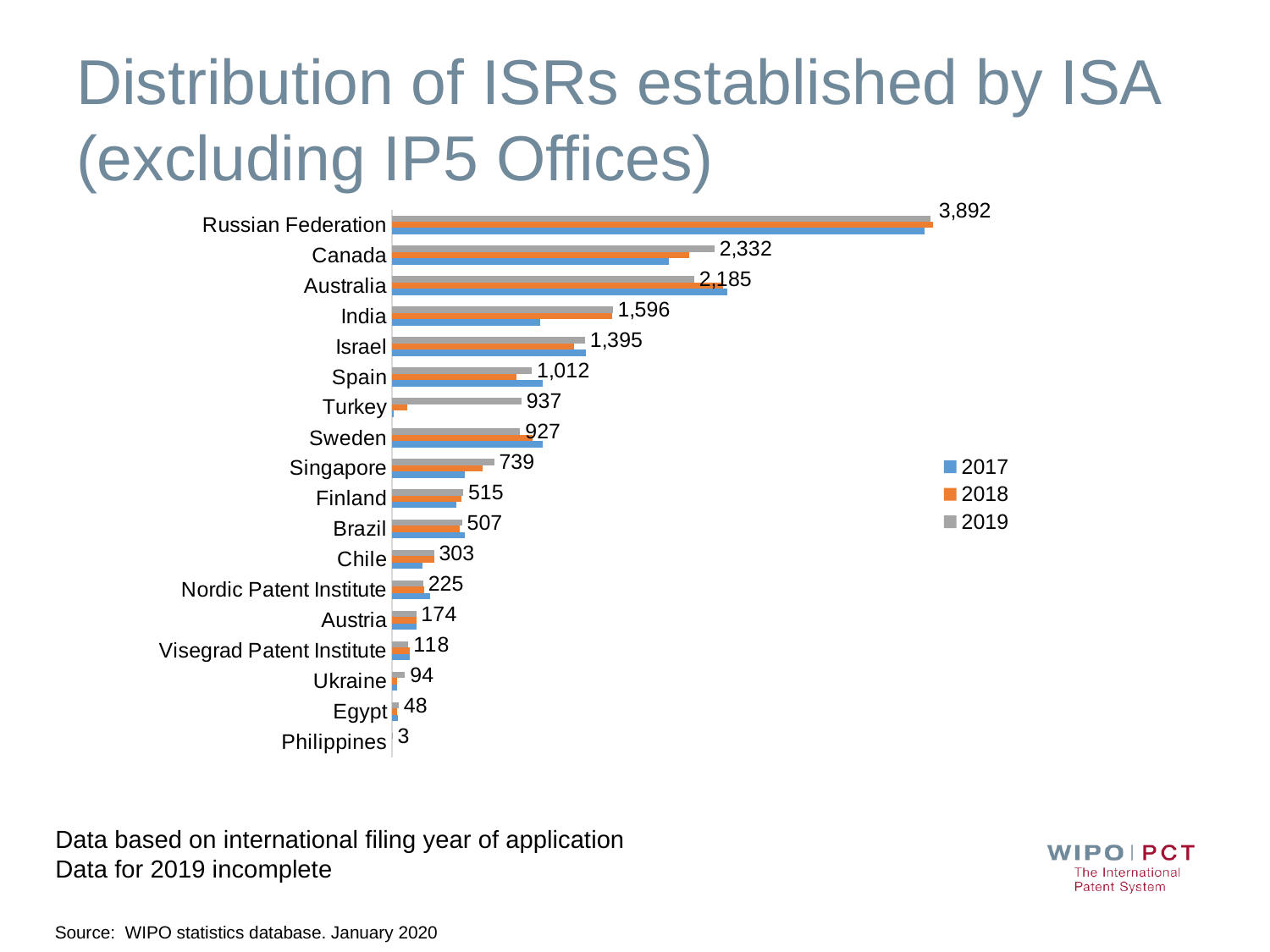
What is the 2019 value for Turkey? 937 Which ISA has the highest 2019 value? Russian Federation How many series does the legend list? 3 What is the difference between the 2019 values for Canada and Australia? 147 Which has the larger 2019 value, Finland or Brazil? Finland What is the 2019 value for the Nordic Patent Institute? 225 What is the 2019 value for India? 1,596 How many ISAs are listed on the chart? 18 For Turkey, which year has the larger value, 2017 or 2019? 2019 What is the 2019 value for the Russian Federation? 3,892 Which ISA has the lowest 2019 value? Philippines What kind of chart is shown on the slide? Bar chart